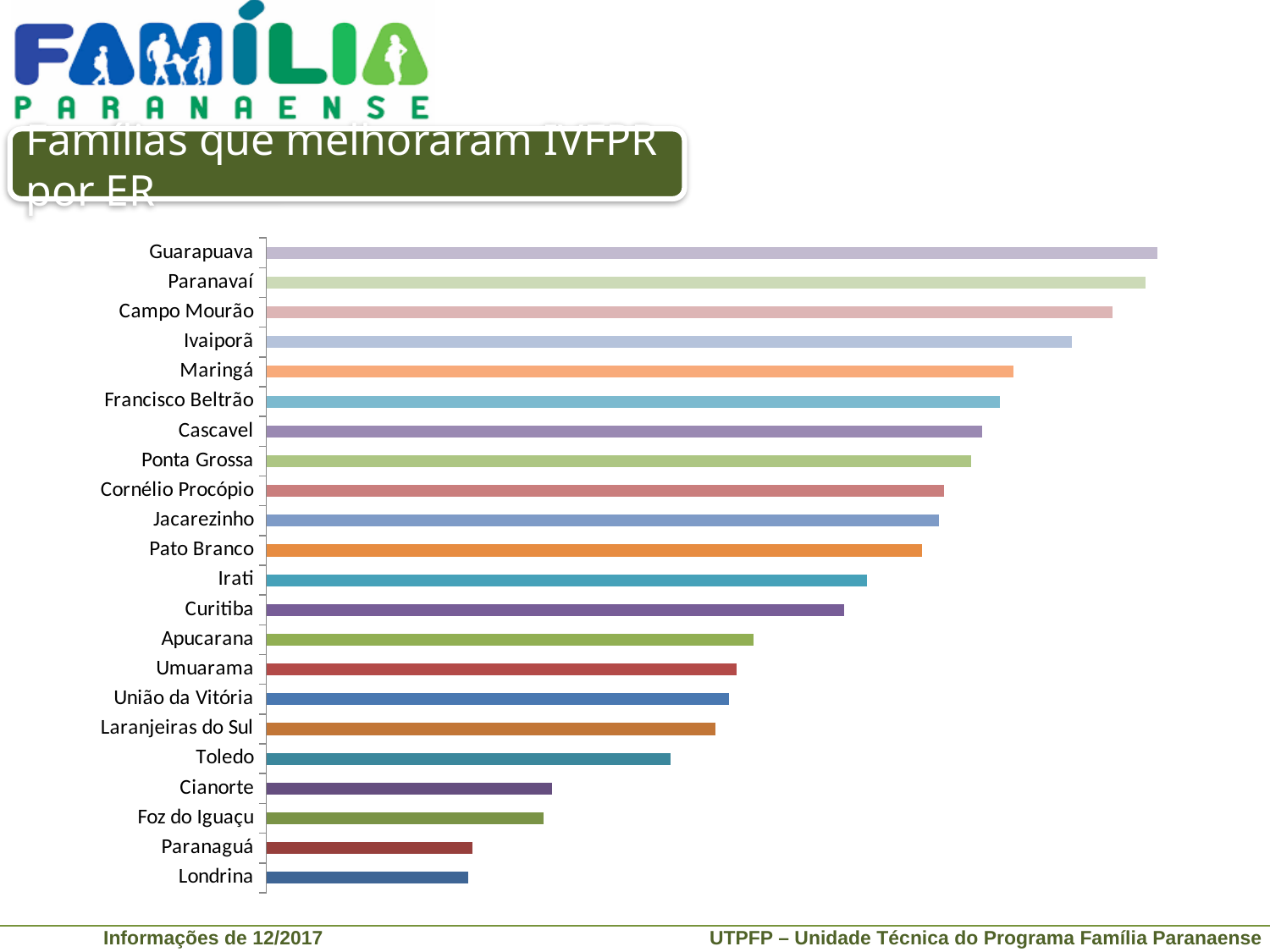
Which category has the shortest bar in the chart? Londrina Which category is listed at the top of the chart? Guarapuava Do the bar lengths increase or decrease going from the top category to the bottom category? decrease Which has the larger value, Maringá or Curitiba? Maringá Which has the larger value, Londrina or Guarapuava? Guarapuava Which category has the longest bar in the chart? Guarapuava Which has the larger value, Toledo or Cianorte? Toledo How many categories (ER) are plotted in the chart? 22 What is the title of the chart on the slide? Famílias que melhoraram IVFPR por ER What kind of chart is shown on the slide? bar chart